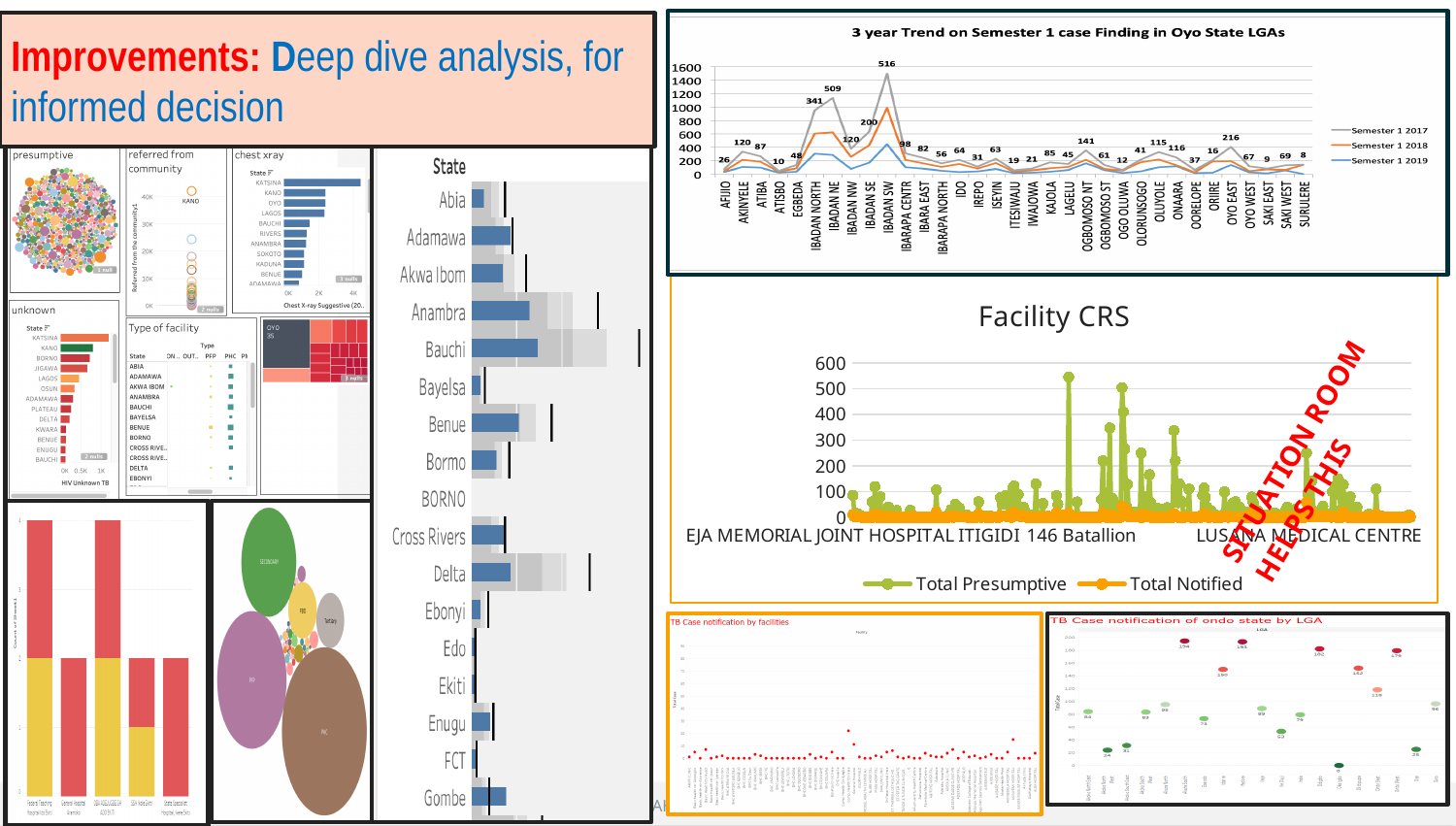
In the chart titled '3 year Trend on Semester 1 case Finding in Oyo State LGAs', what is the labelled value for OYO EAST? 216 In the chart titled 'Facility CRS', how many series does the legend list? 2 In the chart titled '3 year Trend on Semester 1 case Finding in Oyo State LGAs', what is the highest labelled value shown? 516 In the chart titled '3 year Trend on Semester 1 case Finding in Oyo State LGAs', what is the labelled value for IBADAN NORTH? 341 In the chart titled '3 year Trend on Semester 1 case Finding in Oyo State LGAs', what are the legend entries? Semester 1 2017, Semester 1 2018, Semester 1 2019 In the chart headed 'State' in the middle of the slide, what kind of chart is it? bar chart In the chart titled '3 year Trend on Semester 1 case Finding in Oyo State LGAs', what kind of chart is it? line chart In the chart titled 'Facility CRS', what is the highest value shown on the vertical axis? 600 In the chart titled '3 year Trend on Semester 1 case Finding in Oyo State LGAs', how many series does the legend list? 3 In the chart titled 'Facility CRS', what are the legend entries? Total Presumptive, Total Notified In the chart titled '3 year Trend on Semester 1 case Finding in Oyo State LGAs', which LGA has the highest labelled value? IBADAN SW In the chart titled '3 year Trend on Semester 1 case Finding in Oyo State LGAs', what is the difference between the labelled values for IBADAN SW (516) and IBADAN NE (509)? 7